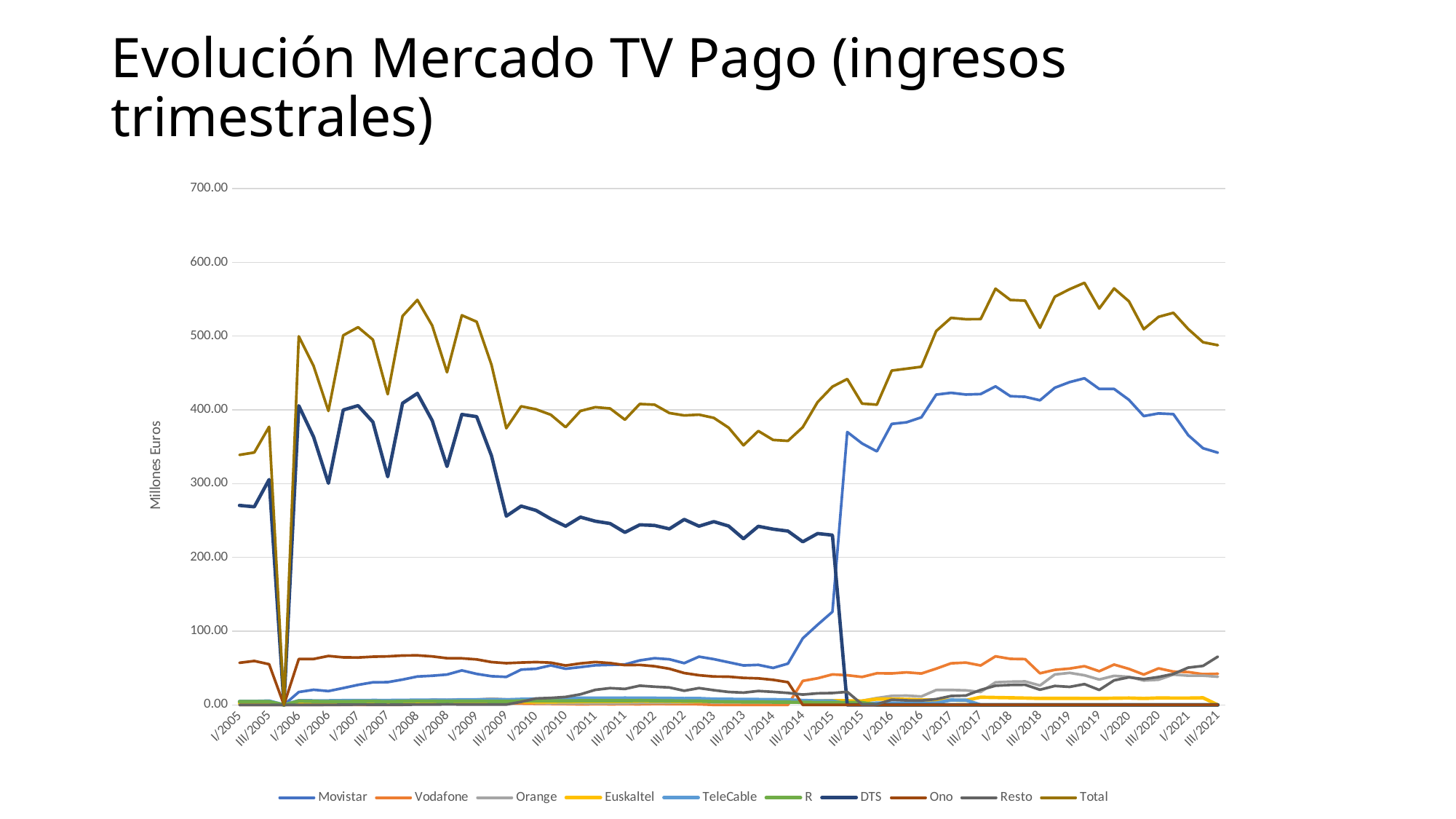
Is the value for Total at III/2009 greater or less than 400? less Is the value for Total at I/2019 greater or less than 500? greater At III/2021, which is larger: Movistar or Vodafone? Movistar Is the value for Movistar at III/2021 greater or less than 400? less Does the Total series rise or fall from I/2019 to III/2021? fall Which series has the highest value at III/2021? Total What kind of chart is shown on the slide? line chart What is the label of the vertical axis? Millones Euros How many series does the legend list? 10 What is the title of the chart? Evolución Mercado TV Pago (ingresos trimestrales)